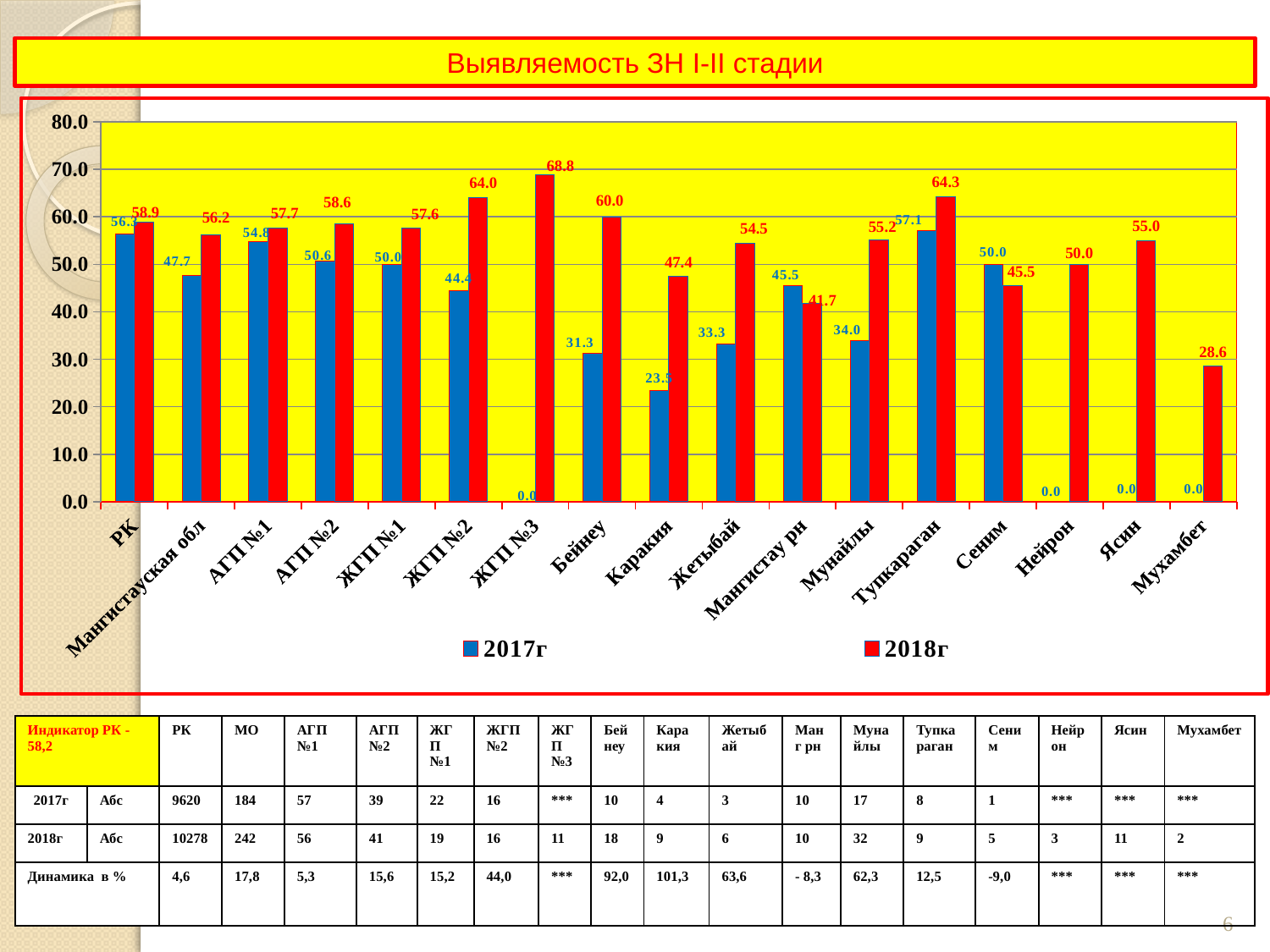
What type of chart is shown on the slide? bar chart How many series does the chart legend list? 2 How many categories are shown on the x axis of the chart? 17 Which category has the highest 2018г value? ЖГП №3 Which category has the lowest 2018г value? Мухамбет What is the 2018г value for Мухамбет? 28.6 For Мангистау рн, which is larger: the 2017г value or the 2018г value? 2017г For Сеним, which is larger: the 2017г value or the 2018г value? 2017г What is the 2017г value for Мангистауская обл? 47.7 What is the 2018г value for ЖГП №3? 68.8 What is the title of the chart on the slide? Выявляемость ЗН I-II стадии What is the difference between the 2018г and 2017г values for Бейнеу? 28.7